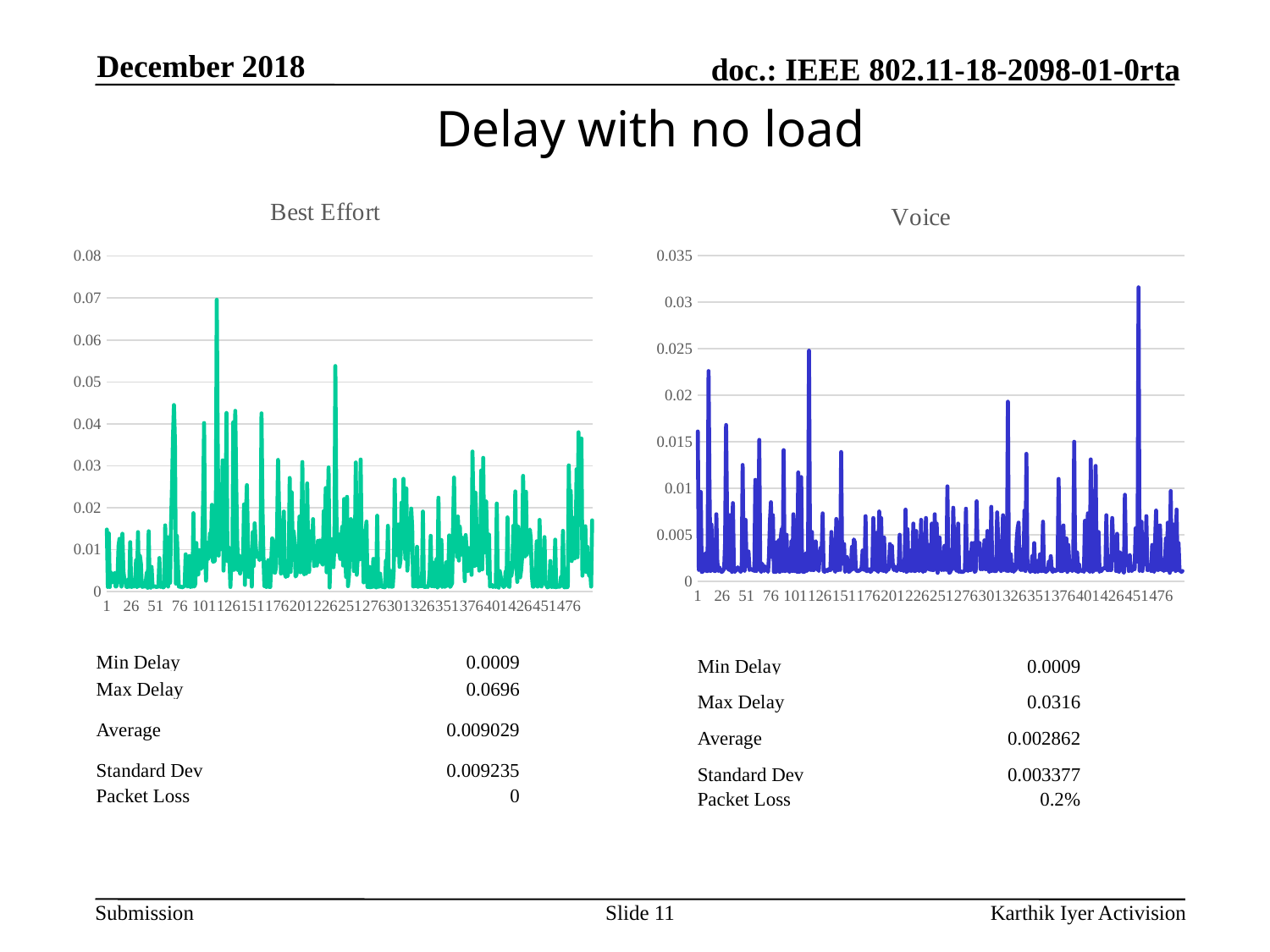
What colour is the line in the Voice chart? blue Which chart reaches a higher peak delay, Best Effort or Voice? Best Effort According to the table below the Best Effort chart, what is the Max Delay? 0.0696 In the Voice chart, is the second-highest peak (near x = 101) greater or less than 0.03? less What is the title of the left chart? Best Effort What kind of chart is the Voice chart? line chart What is the highest value shown on the y axis of the Best Effort chart? 0.08 In the Best Effort chart, is the highest peak greater or less than 0.06? greater According to the table below the Voice chart, what is the Average delay? 0.002862 According to the table below the Voice chart, what is the Max Delay? 0.0316 In the Voice chart, is the highest peak greater or less than 0.03? greater What kind of chart is the Best Effort chart? line chart